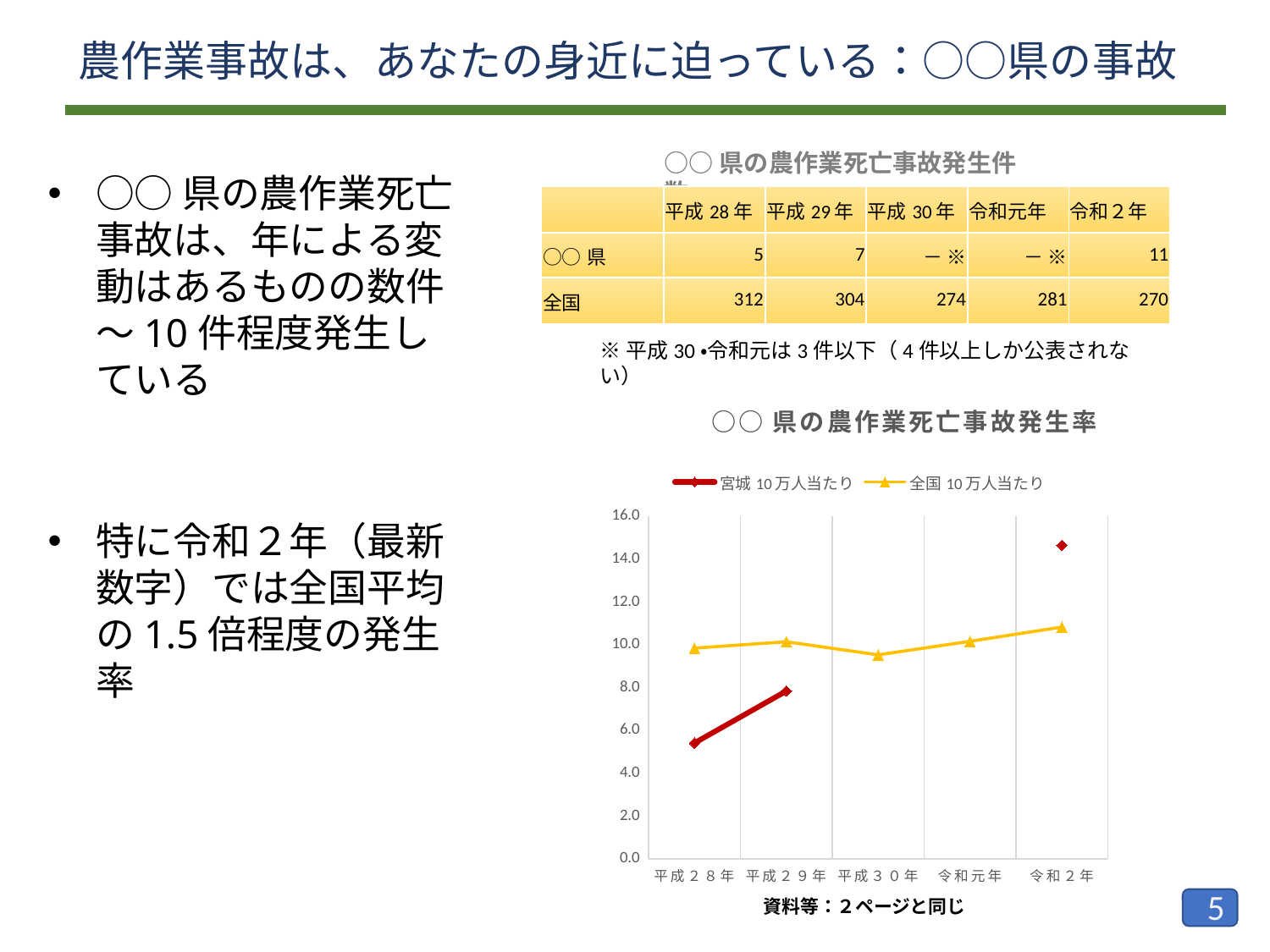
What kind of chart is shown under the title ○○県の農作業死亡事故発生率? line chart How many series does the legend of the line chart list? 2 In the line chart, is the value for 全国 10万人当たり in 平成30年 greater or less than 10.0? less In the line chart, which series has the larger value in 令和2年, 宮城 10万人当たり or 全国 10万人当たり? 宮城 10万人当たり In the line chart, which year has the lowest value for 宮城 10万人当たり? 平成28年 In the line chart, is the value for 宮城 10万人当たり in 令和2年 greater or less than 12.0? greater How many year categories are shown on the x axis of the line chart? 5 In the line chart, is the value for 宮城 10万人当たり in 平成28年 greater or less than 6.0? less In the line chart, which year has the highest value for 宮城 10万人当たり? 令和2年 In the line chart, which series is drawn in red? 宮城 10万人当たり In the line chart, does the value for 宮城 10万人当たり rise or fall from 平成28年 to 平成29年? rise In the line chart, which year has the highest value for 全国 10万人当たり? 令和2年